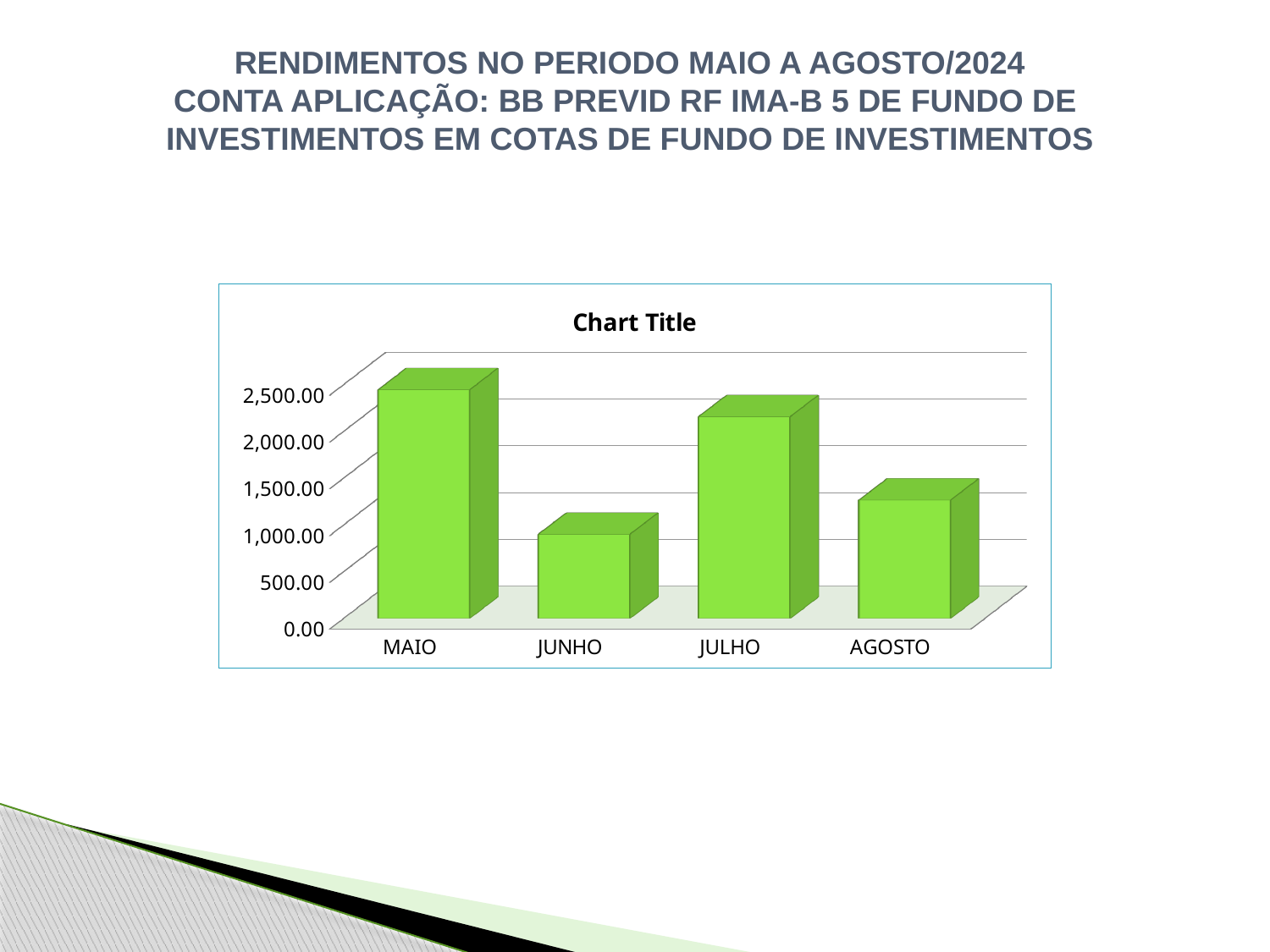
Does the value rise or fall from MAIO to JUNHO? fall Which is larger, the value for MAIO or the value for JULHO? MAIO Which month has the highest value in the chart? MAIO Which month has the lowest value in the chart? JUNHO Is the value for JUNHO greater or less than 1,500.00? less Is the value for JULHO greater or less than 1,500.00? greater What kind of chart is shown on the slide? bar chart What title is printed above the plot area of the chart? Chart Title Is the value for AGOSTO greater or less than 2,000.00? less How many categories are plotted on the x axis of the chart? 4 Which is larger, the value for JULHO or the value for AGOSTO? JULHO